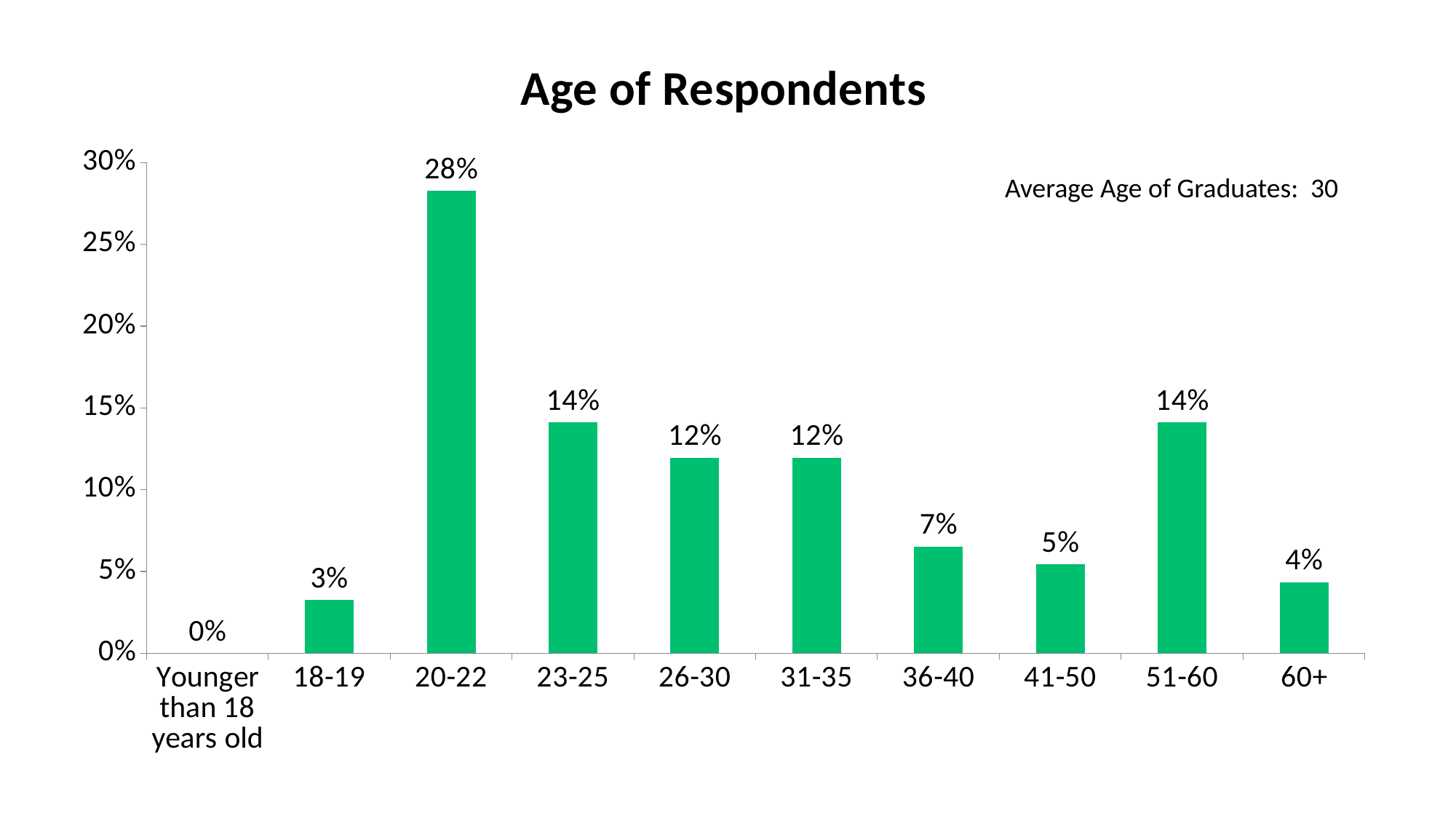
What percentage of respondents are aged 20-22? 28% Which age group has the lowest percentage of respondents? Younger than 18 years old What is the difference in percentage points between the 20-22 and 23-25 age groups? 14% What percentage of respondents are aged 60+? 4% What is the average age of graduates stated on the slide? 30 How many age groups are shown on the x axis? 10 Which age group has a larger share of respondents, 41-50 or 51-60? 51-60 Which age group has the highest percentage of respondents? 20-22 What is the title of the chart? Age of Respondents Is the value for the 26-30 age group greater or less than 10%? greater What kind of chart is shown on the slide? Bar chart What percentage of respondents are aged 36-40? 7%